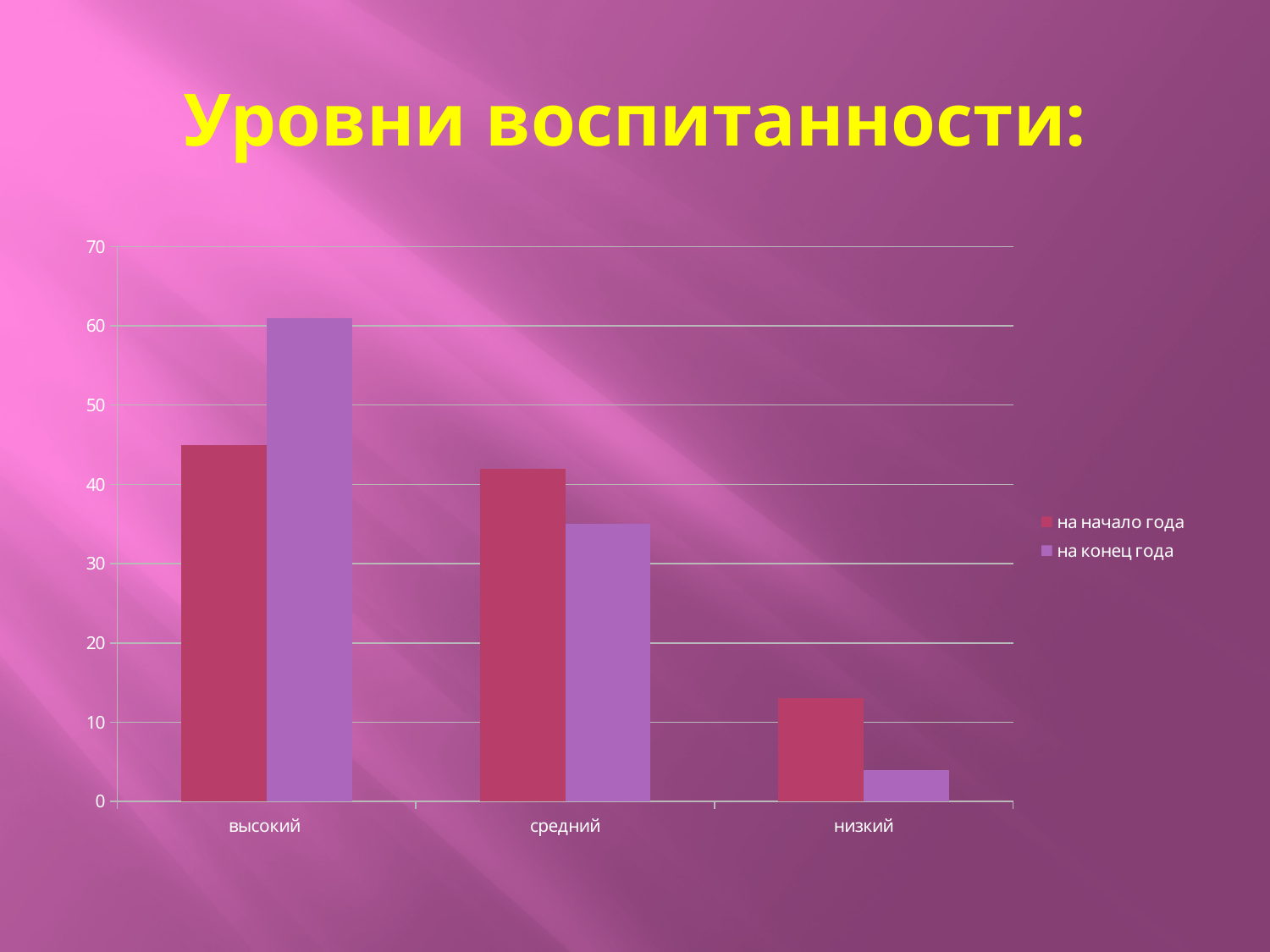
For the category 'средний', which series has the larger value: 'на начало года' or 'на конец года'? на начало года How many series does the legend list? 2 What kind of chart is shown on the slide? bar chart Do the values for the series 'на начало года' rise or fall from 'высокий' to 'низкий' along the x axis? fall How many categories are shown on the x axis? 3 Which category has the highest value for the series 'на конец года'? высокий What is the title of the chart on the slide? Уровни воспитанности: Which category has the lowest value for the series 'на начало года'? низкий Is the value for 'низкий' in the series 'на конец года' greater or less than 10? less Is the value for 'средний' in the series 'на начало года' greater or less than 40? greater For the category 'высокий', which series has the larger value: 'на начало года' or 'на конец года'? на конец года